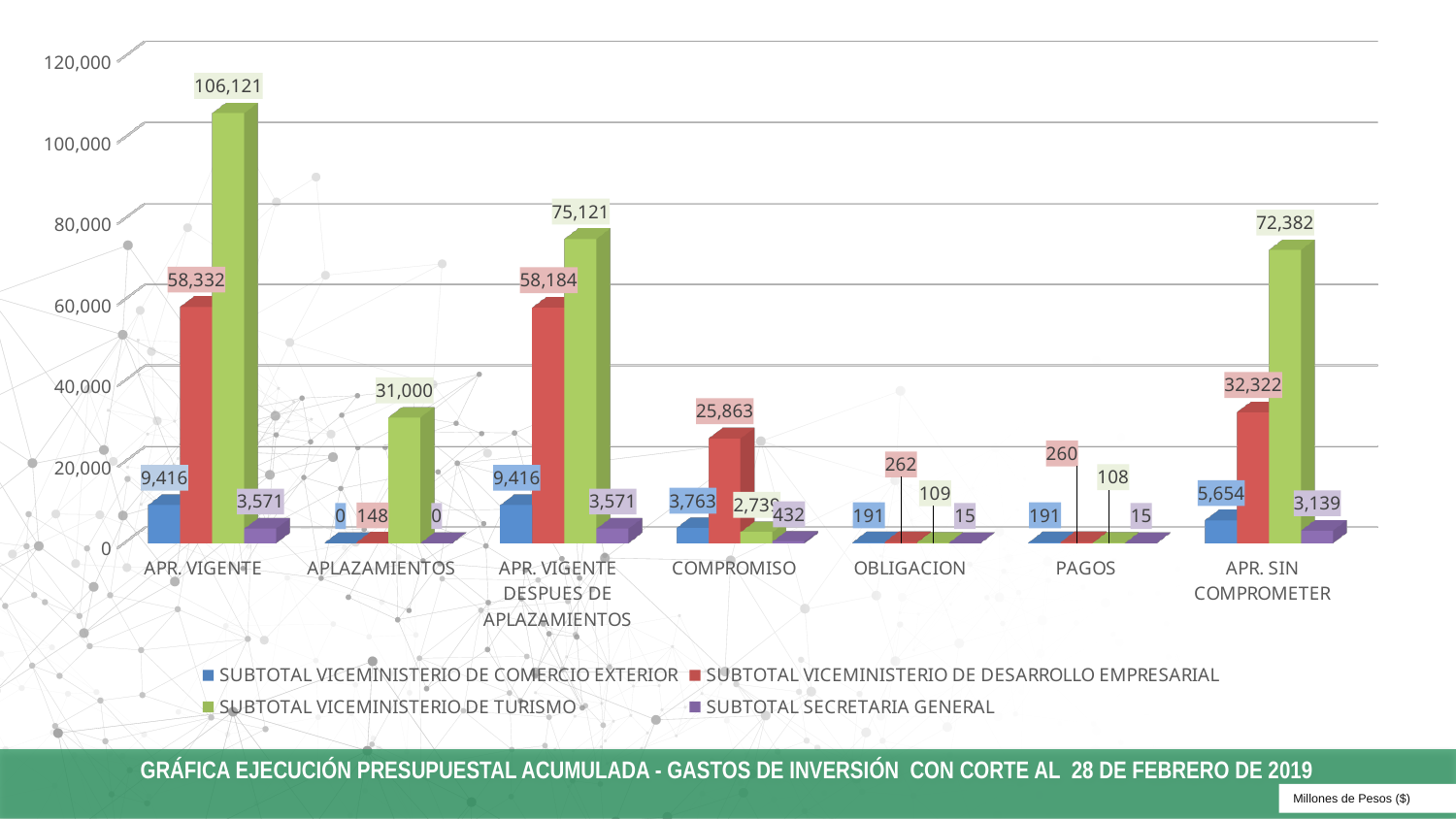
How many series does the legend list? 4 What is the title of the chart? GRÁFICA EJECUCIÓN PRESUPUESTAL ACUMULADA - GASTOS DE INVERSIÓN CON CORTE AL 28 DE FEBRERO DE 2019 How many categories are shown on the x axis? 7 What is the value for SUBTOTAL VICEMINISTERIO DE DESARROLLO EMPRESARIAL in the COMPROMISO category? 25,863 What is the difference between the SUBTOTAL VICEMINISTERIO DE TURISMO values for APR. VIGENTE and APR. VIGENTE DESPUES DE APLAZAMIENTOS? 31,000 Is the value for SUBTOTAL VICEMINISTERIO DE DESARROLLO EMPRESARIAL in APR. SIN COMPROMETER greater or less than 40,000? less What type of chart is shown on the slide? Bar chart What is the value for SUBTOTAL SECRETARIA GENERAL in the APR. SIN COMPROMETER category? 3,139 Which series has the lowest value in the OBLIGACION category? SUBTOTAL SECRETARIA GENERAL Which series has the highest value in the APLAZAMIENTOS category? SUBTOTAL VICEMINISTERIO DE TURISMO What is the value for SUBTOTAL VICEMINISTERIO DE TURISMO in the APR. VIGENTE category? 106,121 Which is larger in the COMPROMISO category: SUBTOTAL VICEMINISTERIO DE COMERCIO EXTERIOR or SUBTOTAL VICEMINISTERIO DE TURISMO? SUBTOTAL VICEMINISTERIO DE COMERCIO EXTERIOR